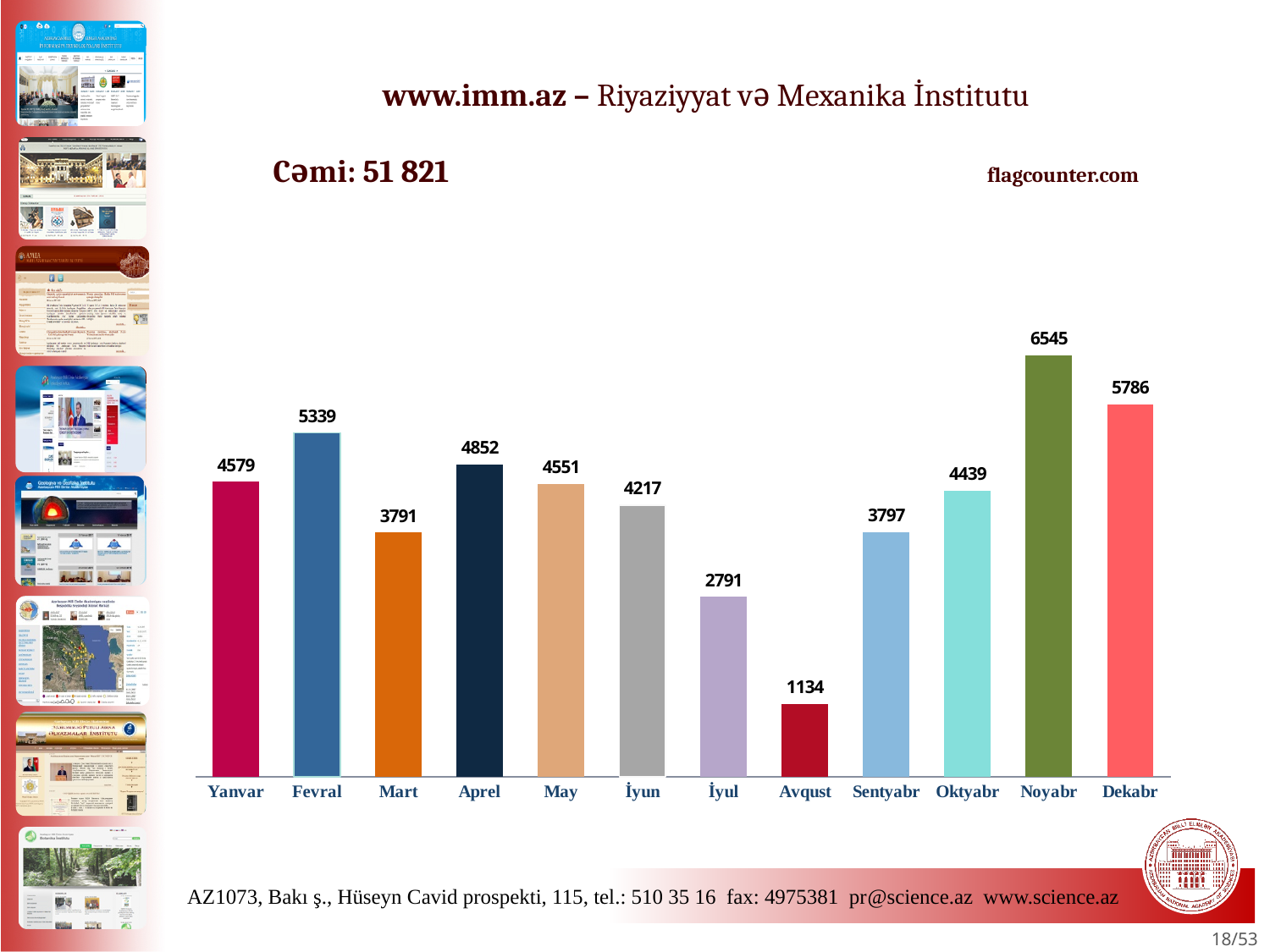
What is the value for Avqust? 1134 What is the difference between the values for Noyabr and Dekabr? 759 Which is larger, the value for Aprel or the value for May? Aprel How many months are shown on the chart? 12 Which month has the highest value? Noyabr What is the value for Noyabr? 6545 What is the value for Sentyabr? 3797 What is the difference between the values for Fevral and Mart? 1548 What is the value for Fevral? 5339 Which month has the lowest value? Avqust Do the values rise or fall from İyun to Avqust? Fall What kind of chart is shown on the slide? Bar chart